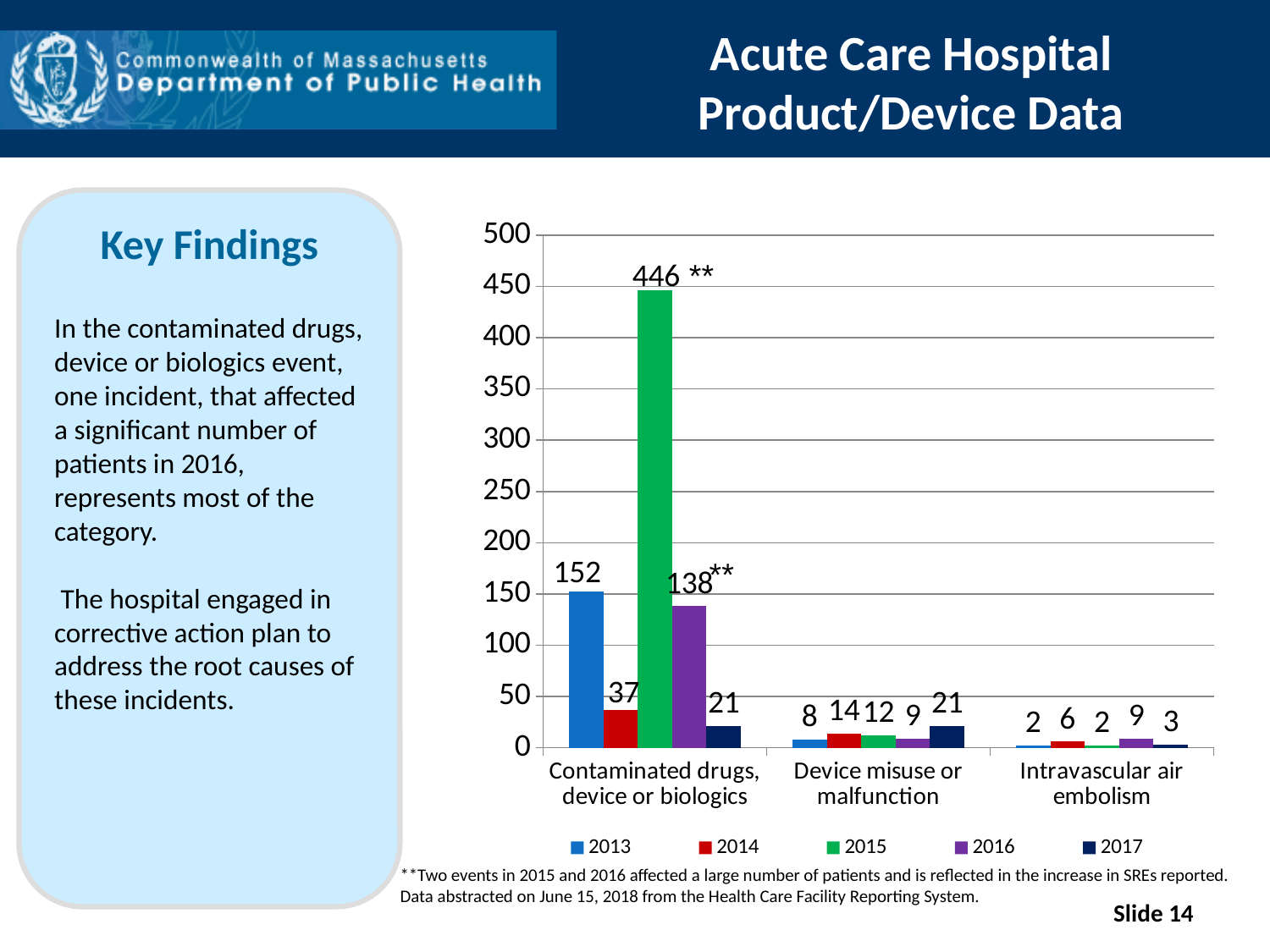
Which year has the lowest value in the Device misuse or malfunction category? 2013 What is the value for 2015 in the Contaminated drugs, device or biologics category? 446 How many series does the chart legend list? 5 What is the value for 2016 in the Intravascular air embolism category? 9 What kind of chart is shown on the slide? Bar chart What is the value for 2017 in the Device misuse or malfunction category? 21 Which is larger in the Device misuse or malfunction category: the 2014 value or the 2015 value? 2014 Which year has the highest value in the Contaminated drugs, device or biologics category? 2015 What is the difference between the 2015 and 2013 values in the Contaminated drugs, device or biologics category? 294 What is the difference between the 2016 and 2017 values in the Contaminated drugs, device or biologics category? 117 How many categories are shown on the x axis of the chart? 3 What is the value for 2013 in the Contaminated drugs, device or biologics category? 152